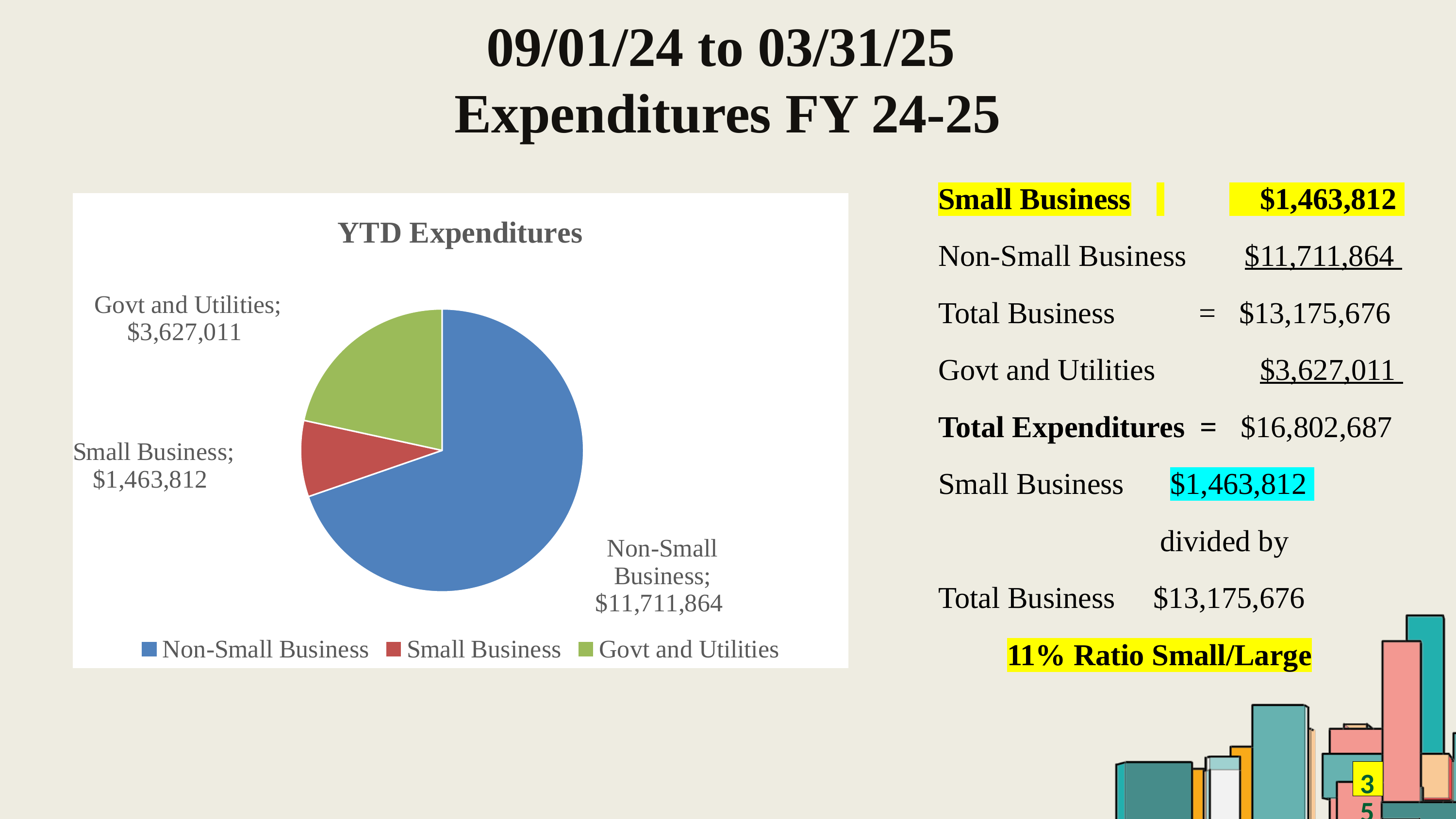
What is the value of the Non-Small Business slice? $11,711,864 Which category has the largest slice of the pie? Non-Small Business What type of chart is shown on the slide? pie chart What colour is the Govt and Utilities slice? green What is the title of the chart? YTD Expenditures Which is larger, the Govt and Utilities slice or the Small Business slice? Govt and Utilities How many entries does the chart legend list? 3 Which category has the smallest slice of the pie? Small Business What is the difference between the Non-Small Business value and the Small Business value? $10,248,052 How many slices does the pie chart have? 3 What is the value of the Govt and Utilities slice? $3,627,011 What is the value of the Small Business slice? $1,463,812